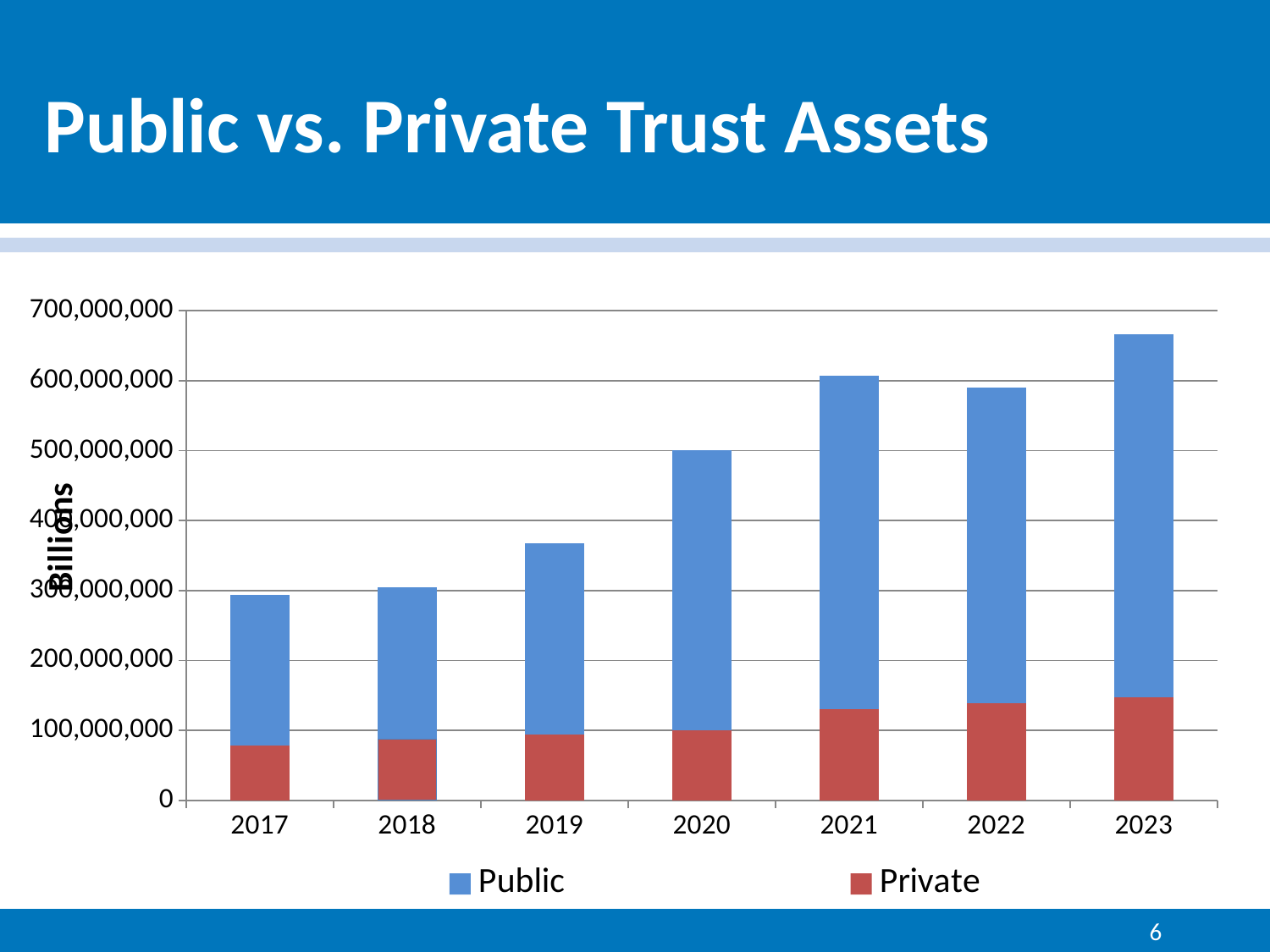
Is the Private value for 2023 greater or less than 100,000,000? greater What is the label on the vertical axis? Billions Which year has a larger total bar, 2021 or 2022? 2021 Is the Private value for 2017 greater or less than 100,000,000? less Do the Private values rise or fall from 2017 to 2023? rise Is the total bar for 2023 greater or less than 600,000,000? greater What kind of chart is shown on the slide? Bar chart Which year has the lowest total trust assets (Public plus Private)? 2017 How many years are shown on the x axis? 7 Which year has the highest total trust assets (Public plus Private)? 2023 How many series does the legend list? 2